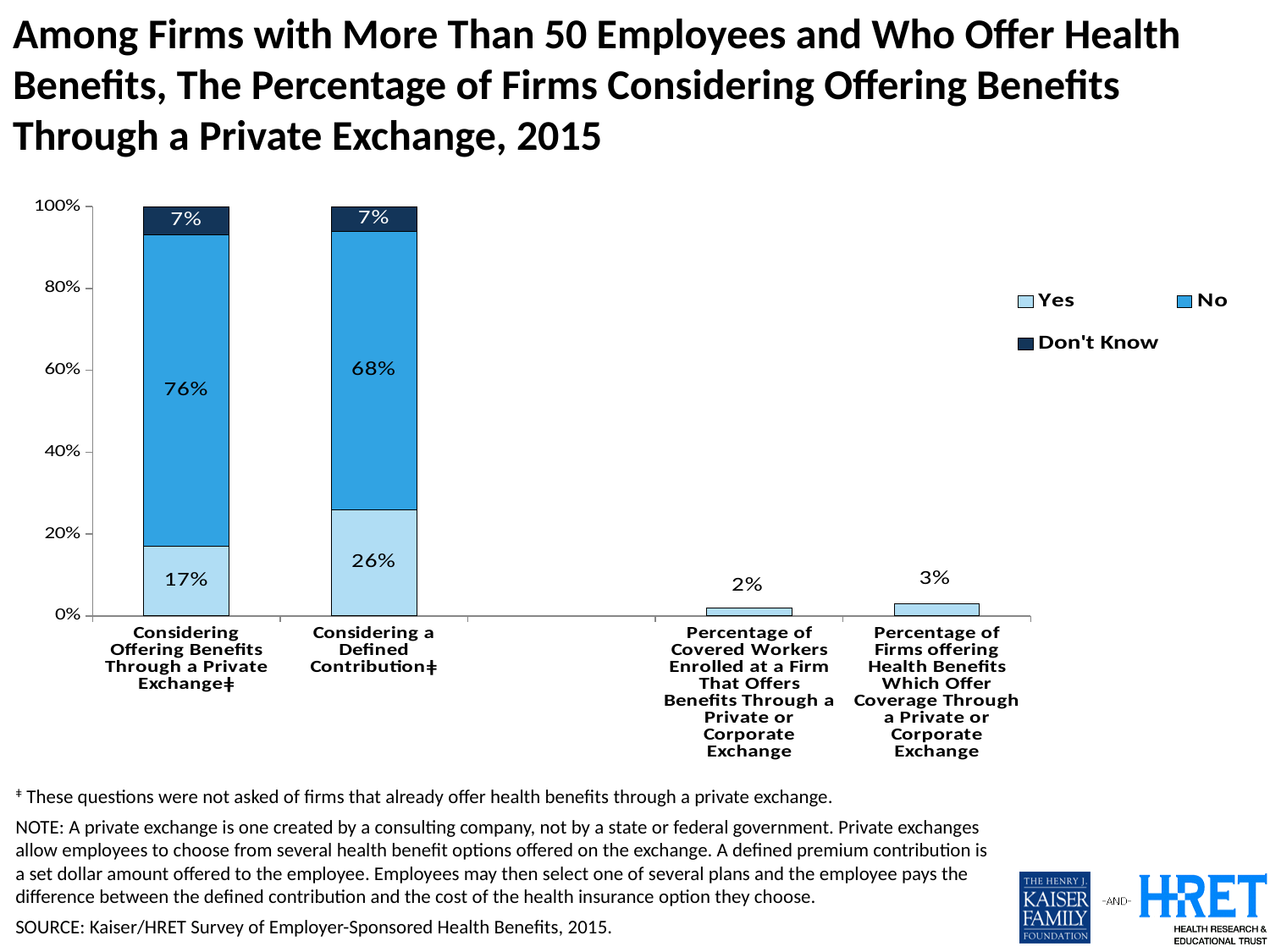
What percentage of firms answered "Yes" to considering offering benefits through a private exchange? 17% How many series does the legend list? 3 What is the difference between the "Yes" values for "Considering a Defined Contribution" and "Considering Offering Benefits Through a Private Exchange"? 9% What is the value shown for "Percentage of Covered Workers Enrolled at a Firm That Offers Benefits Through a Private or Corporate Exchange"? 2% Which is larger: the "No" value for "Considering Offering Benefits Through a Private Exchange" or the "No" value for "Considering a Defined Contribution"? Considering Offering Benefits Through a Private Exchange How many categories are shown on the x axis? 4 Which legend entry is shown in the darkest colour? Don't Know What kind of chart is shown on the slide? Stacked bar chart Which category has the highest "Yes" value? Considering a Defined Contribution What is the value shown for "Percentage of Firms offering Health Benefits Which Offer Coverage Through a Private or Corporate Exchange"? 3% What is the "Don't Know" value for the "Considering Offering Benefits Through a Private Exchange" bar? 7% What percentage of firms answered "No" to considering a defined contribution? 68%